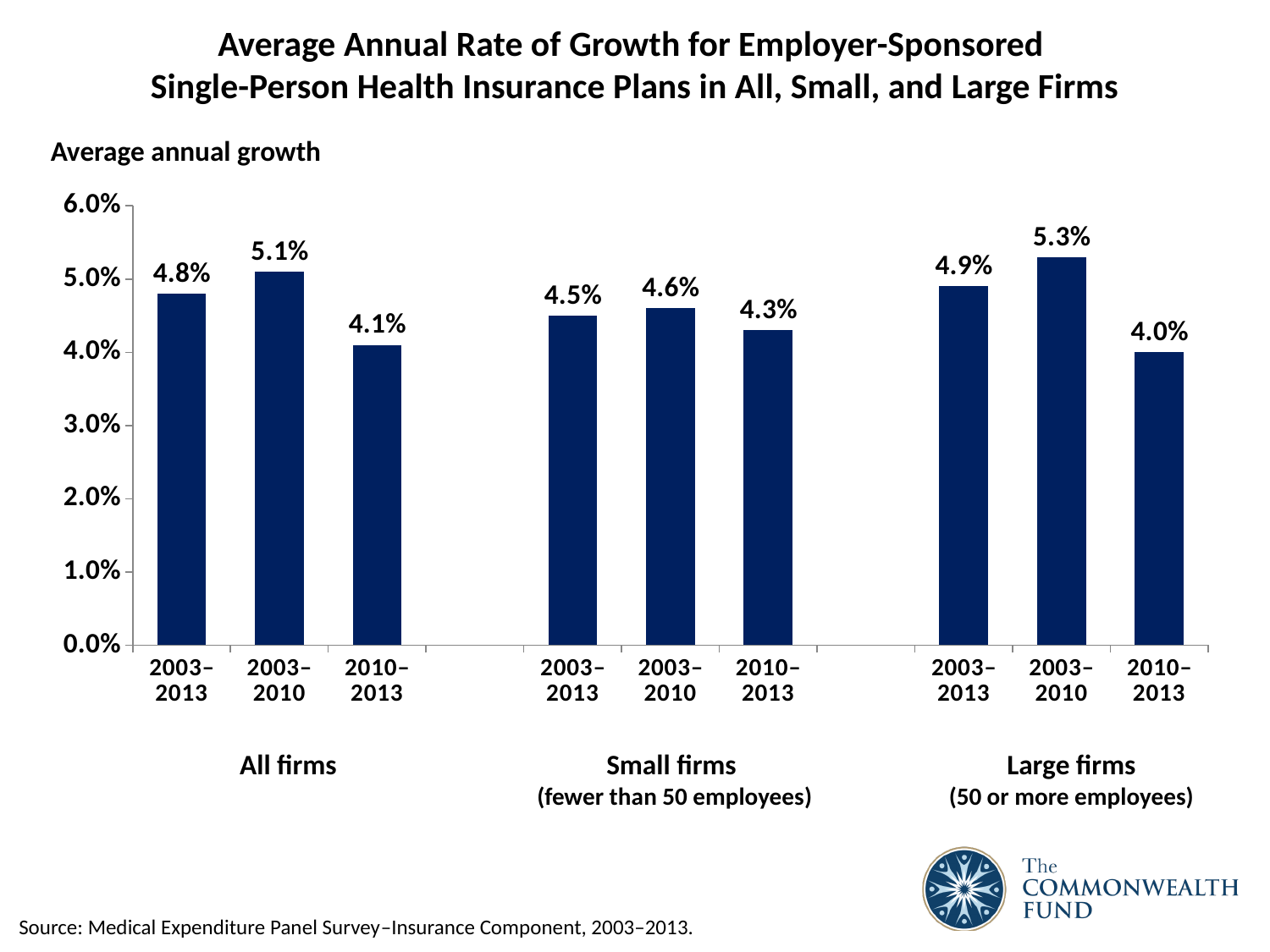
What is the label on the vertical axis of the chart? Average annual growth Which is larger: the 2003–2013 growth rate for Small firms or for Large firms? Large firms What is the average annual growth for Large firms in 2003–2010? 5.3% What is the difference between the 2003–2010 and 2010–2013 growth rates for All firms? 1.0% What is the average annual growth for Small firms in 2010–2013? 4.3% What is the average annual growth for All firms in 2003–2013? 4.8% Is the 2003–2010 growth rate for All firms greater or less than 5.0%? greater Which bar shows the lowest average annual growth? Large firms, 2010–2013 What kind of chart is shown on the slide? Bar chart How many bars are plotted on the chart? 9 What is the difference between the 2003–2010 and 2010–2013 growth rates for Large firms? 1.3% Which bar shows the highest average annual growth? Large firms, 2003–2010